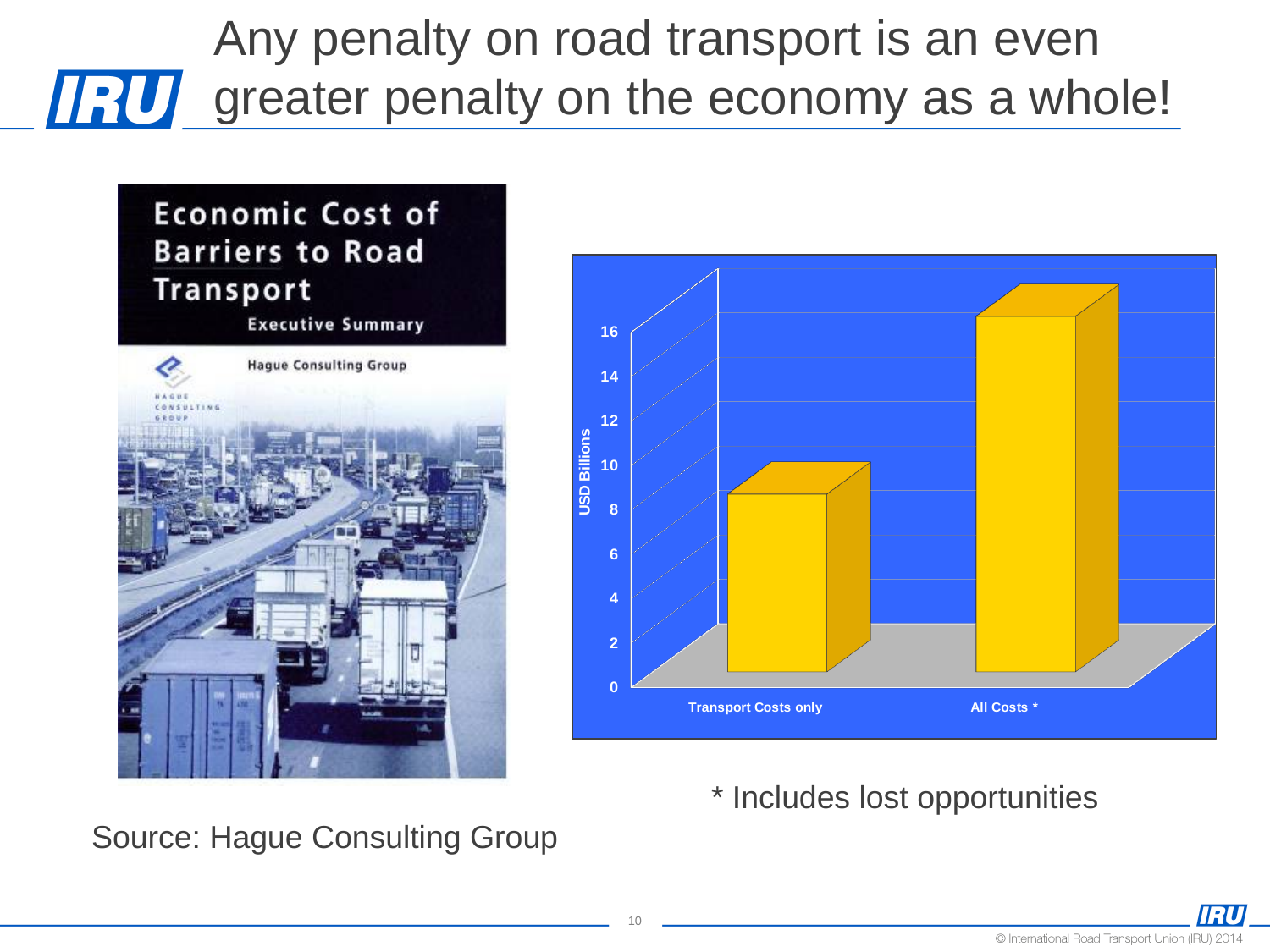
Is the value for All Costs * greater or less than 12? greater What colour are the bars in the chart? yellow Is the value for All Costs * greater or less than 10? greater How many categories are plotted on the chart? 2 Which is larger, the value for Transport Costs only or the value for All Costs *? All Costs * Which category has the highest value on the chart? All Costs * What is the label on the vertical axis of the chart? USD Billions Is the value for Transport Costs only greater or less than 12? less Which category has the lowest value on the chart? Transport Costs only What kind of chart is shown on the slide? bar chart